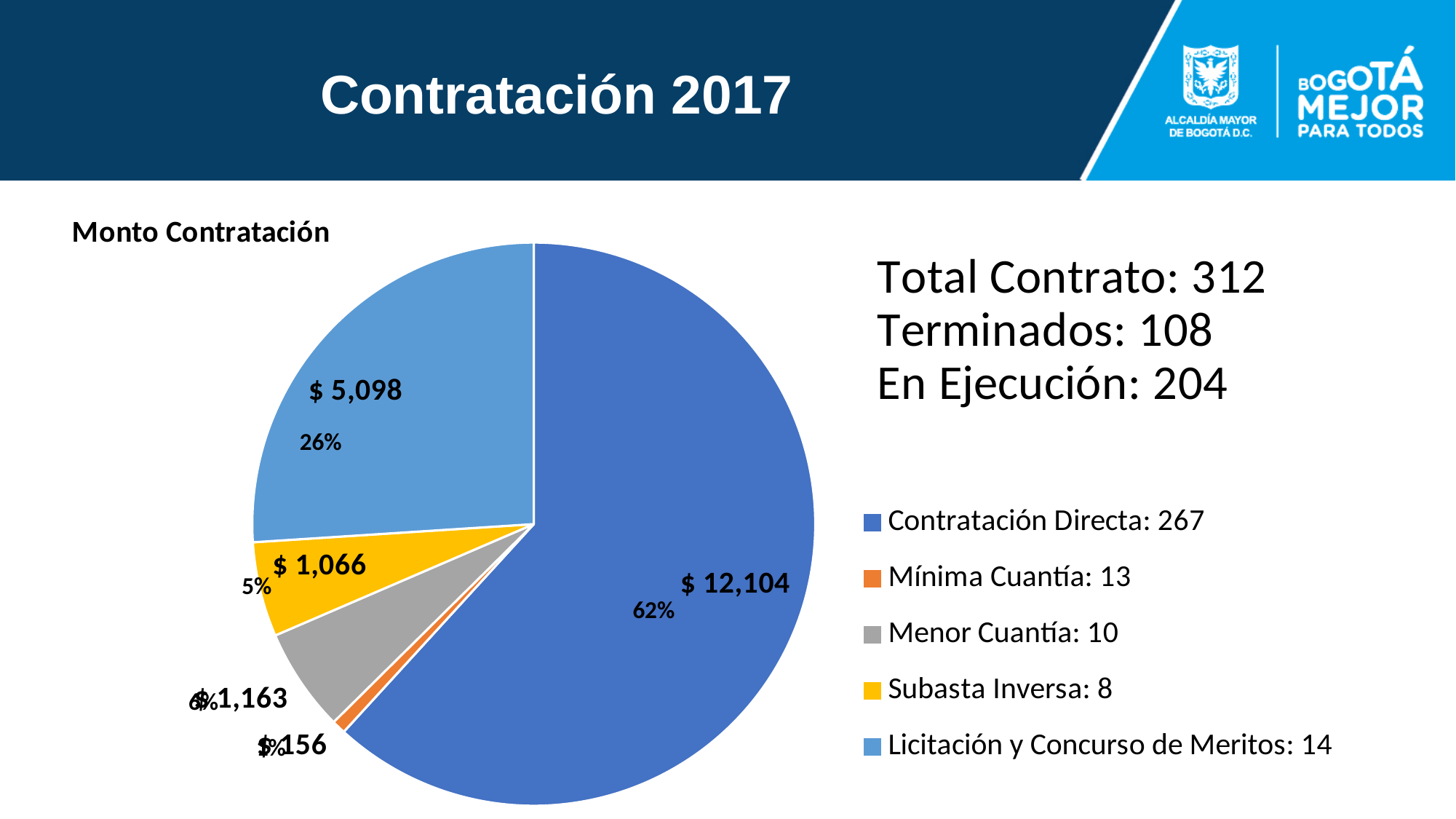
What is the title of the chart? Monto Contratación Which category has the largest slice of the pie? Contratación Directa What is the value shown for Subasta Inversa? $ 1,066 How many slices does the pie chart have? 5 What is the value shown for Menor Cuantía? $ 1,163 What type of chart is shown on the slide? pie chart What is the value shown for Contratación Directa? $ 12,104 What is the difference between the values for Contratación Directa and Licitación y Concurso de Meritos? $ 7,006 What is the value shown for Licitación y Concurso de Meritos? $ 5,098 Which category has the smallest slice of the pie? Mínima Cuantía What share of the pie does Licitación y Concurso de Meritos represent? 26% Which is larger, the value for Menor Cuantía or the value for Subasta Inversa? Menor Cuantía